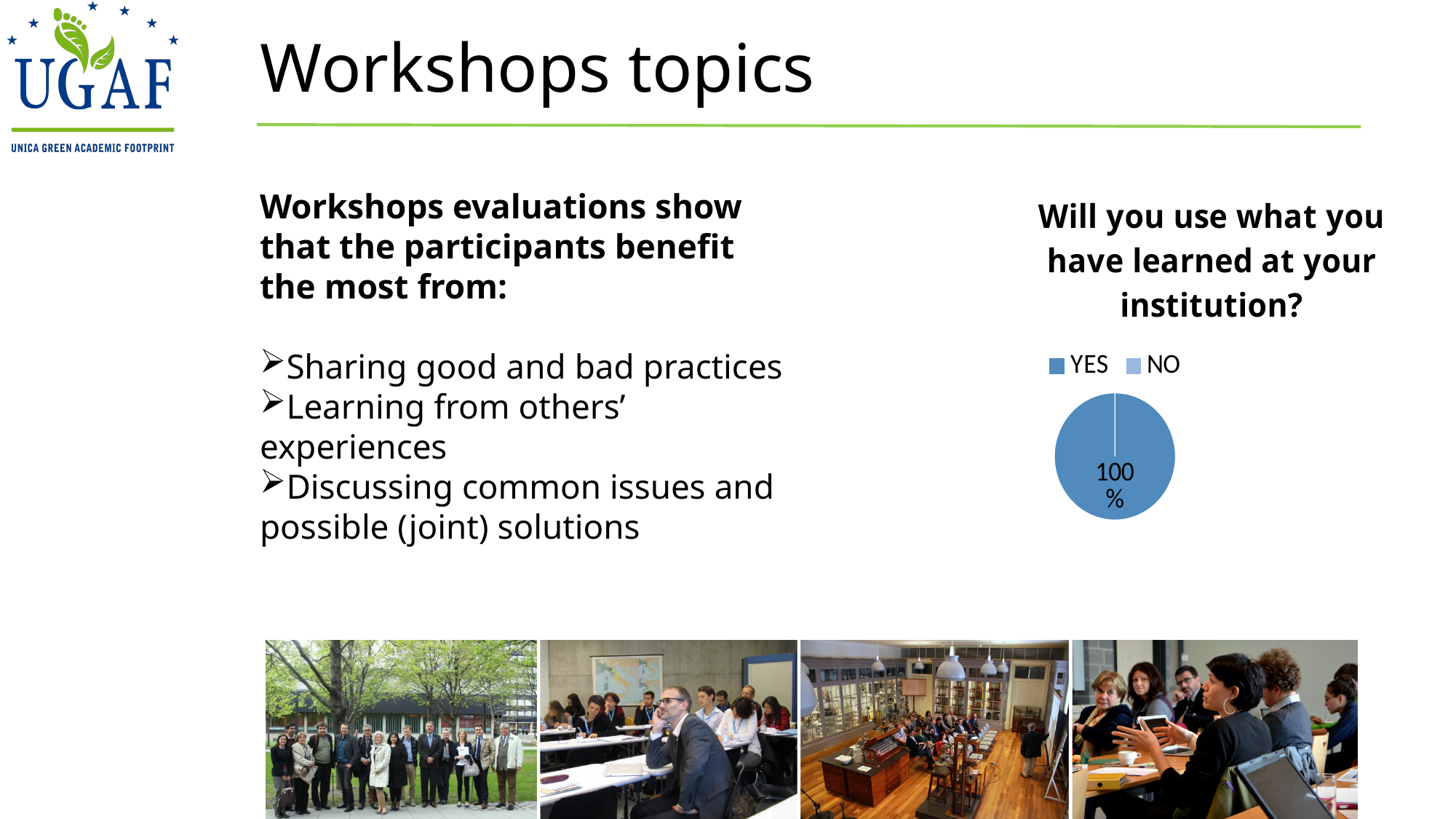
Which category has the smallest share of the pie chart? NO Which is larger in the pie chart, YES or NO? YES Which category has the largest share of the pie chart? YES How many entries does the legend of the pie chart list? 2 What value is printed on the pie chart? 100% Is the share for YES greater or less than 50%? greater What are the legend entries of the pie chart? YES and NO What is the title of the pie chart? Will you use what you have learned at your institution? What kind of chart is shown on the slide? pie chart What share of the pie chart does YES account for? 100%